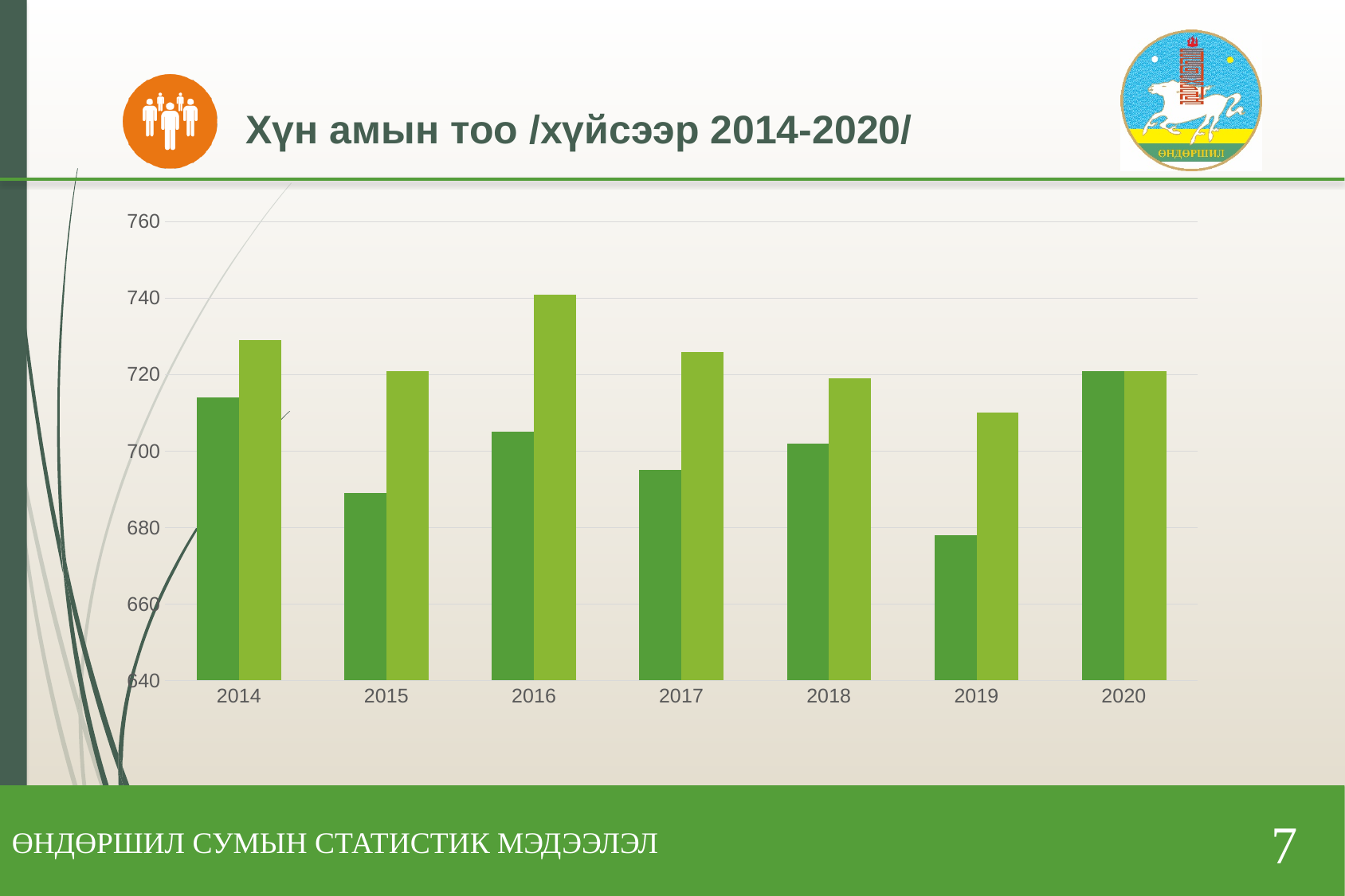
In which year is the dark green bar the lowest? 2019 What is the title of the chart on the slide? Хүн амын тоо /хүйсээр 2014-2020/ For 2016, which bar is larger, the dark green or the light green? light green Which is larger, the dark green bar for 2014 or the dark green bar for 2015? 2014 In which year is the light green bar the lowest? 2019 Is the value of the dark green bar for 2015 greater or less than 700? less In which year is the light green bar the highest? 2016 Is the value of the light green bar for 2016 greater or less than 720? greater How many bars are plotted for each year in the chart? 2 How many years are shown on the x axis of the chart? 7 What kind of chart is shown on the slide? bar chart